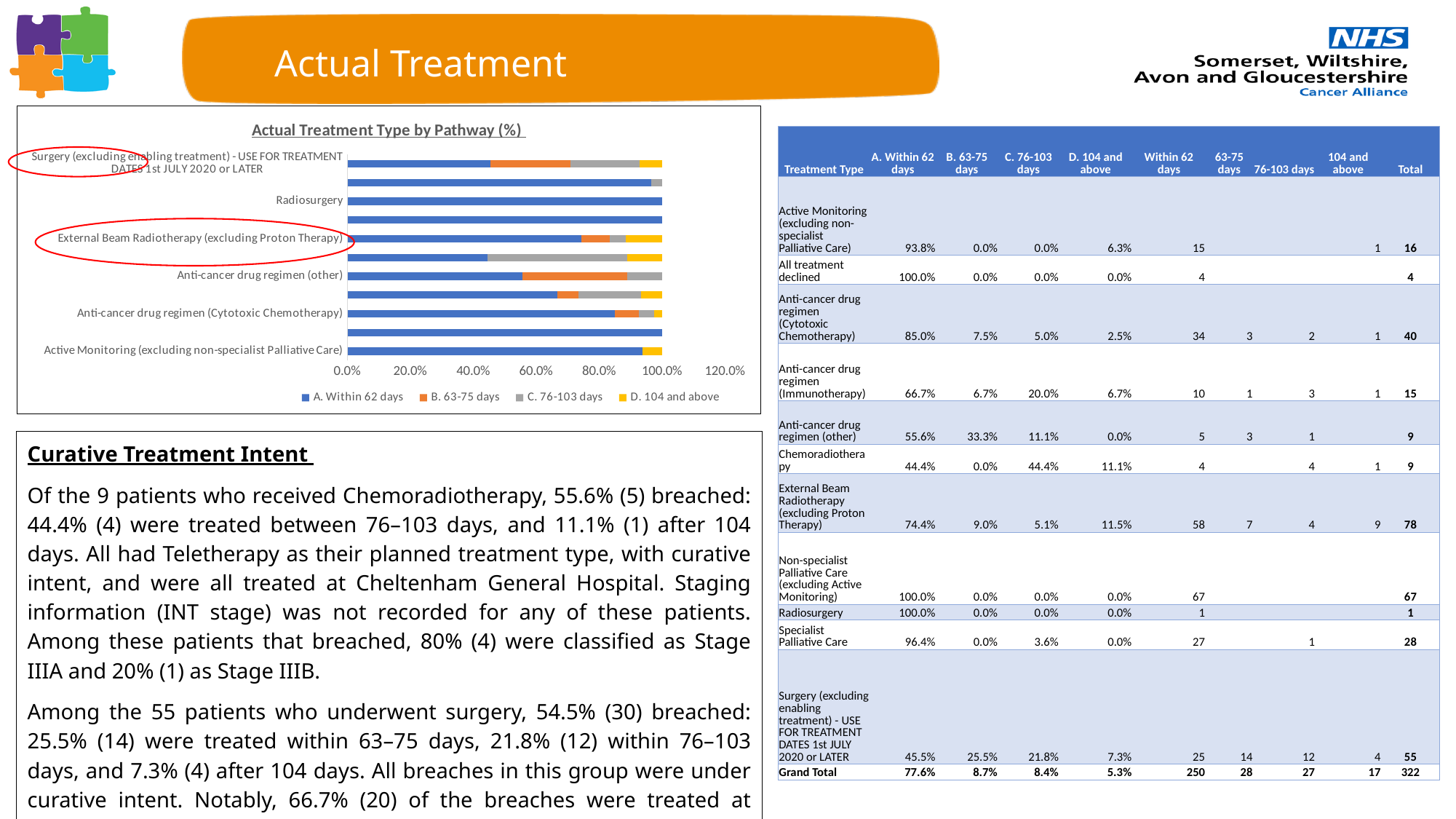
How many series does the chart's legend list? 4 Is the 'A. Within 62 days' value for Active Monitoring (excluding non-specialist Palliative Care) greater or less than 80.0%? greater Is the 'A. Within 62 days' value for Surgery (excluding enabling treatment) greater or less than 60.0%? less Which colour represents the 'D. 104 and above' series in the chart? Yellow Is the 'A. Within 62 days' value for Radiosurgery greater or less than 80.0%? greater Which has the larger 'A. Within 62 days' share: Anti-cancer drug regimen (Cytotoxic Chemotherapy) or External Beam Radiotherapy (excluding Proton Therapy)? Anti-cancer drug regimen (Cytotoxic Chemotherapy) What kind of chart is shown on the slide? Stacked bar chart Which has the larger 'A. Within 62 days' share: Radiosurgery or Surgery (excluding enabling treatment)? Radiosurgery How many bars are plotted in the chart? 11 What is the title of the chart on the slide? Actual Treatment Type by Pathway (%)